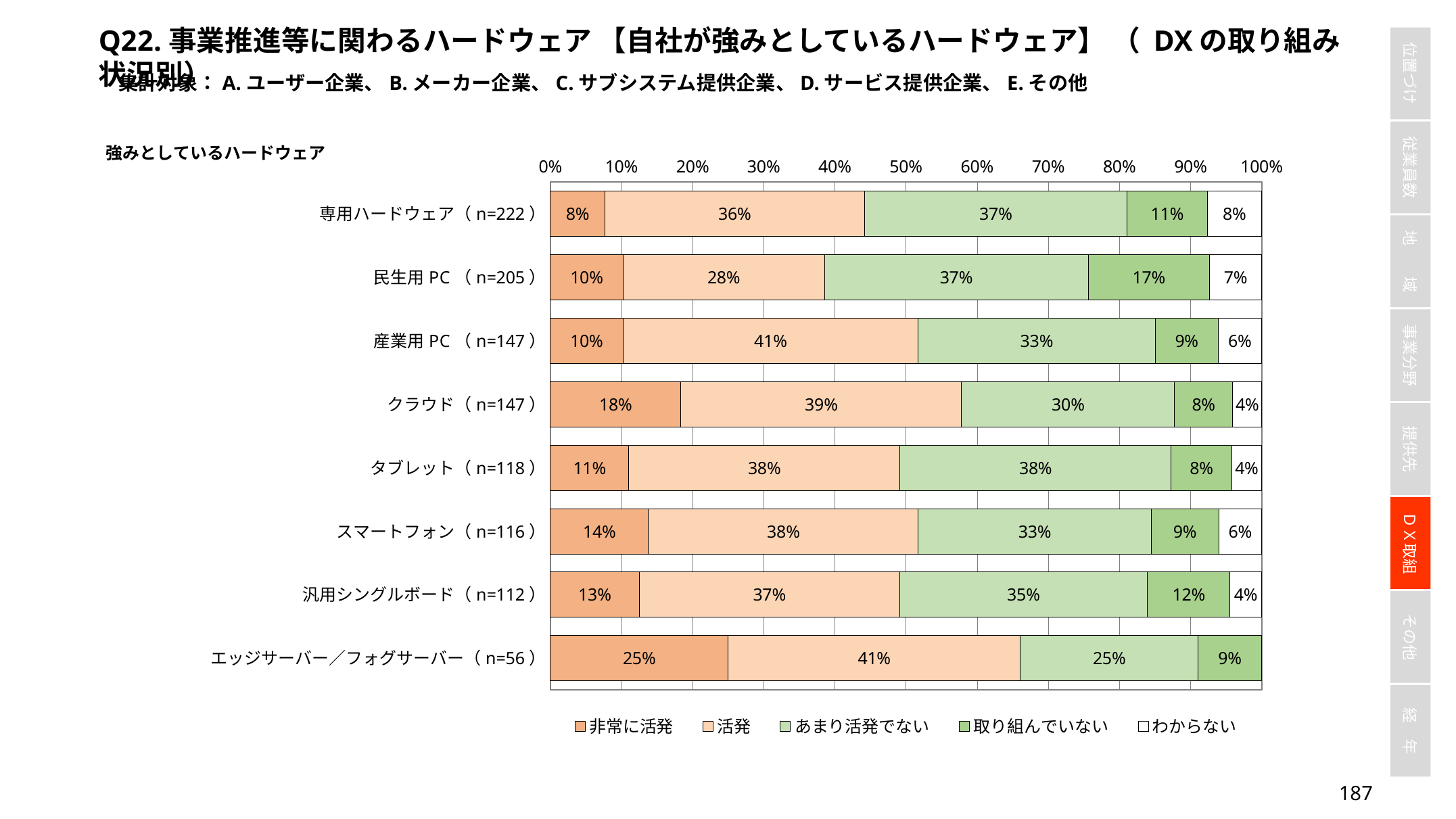
How many hardware categories are plotted in the chart? 8 What is the combined share of 非常に活発 and 活発 for スマートフォン (n=116)? 52% What type of chart is shown on the slide? Stacked bar chart Which legend entry is shown in the darkest green colour? 取り組んでいない What is the difference between the 活発 values for 専用ハードウェア (n=222) and 民生用PC (n=205)? 8% How many series does the legend list? 5 Which category has the lowest 非常に活発 value? 専用ハードウェア (n=222) What is the 非常に活発 value for エッジサーバー／フォグサーバー (n=56)? 25% What is the 活発 value for 産業用PC (n=147)? 41% What is the 取り組んでいない value for 民生用PC (n=205)? 17% Which is larger: the 非常に活発 value for クラウド (n=147) or for タブレット (n=118)? クラウド (n=147) Which category has the highest 非常に活発 value? エッジサーバー／フォグサーバー (n=56)